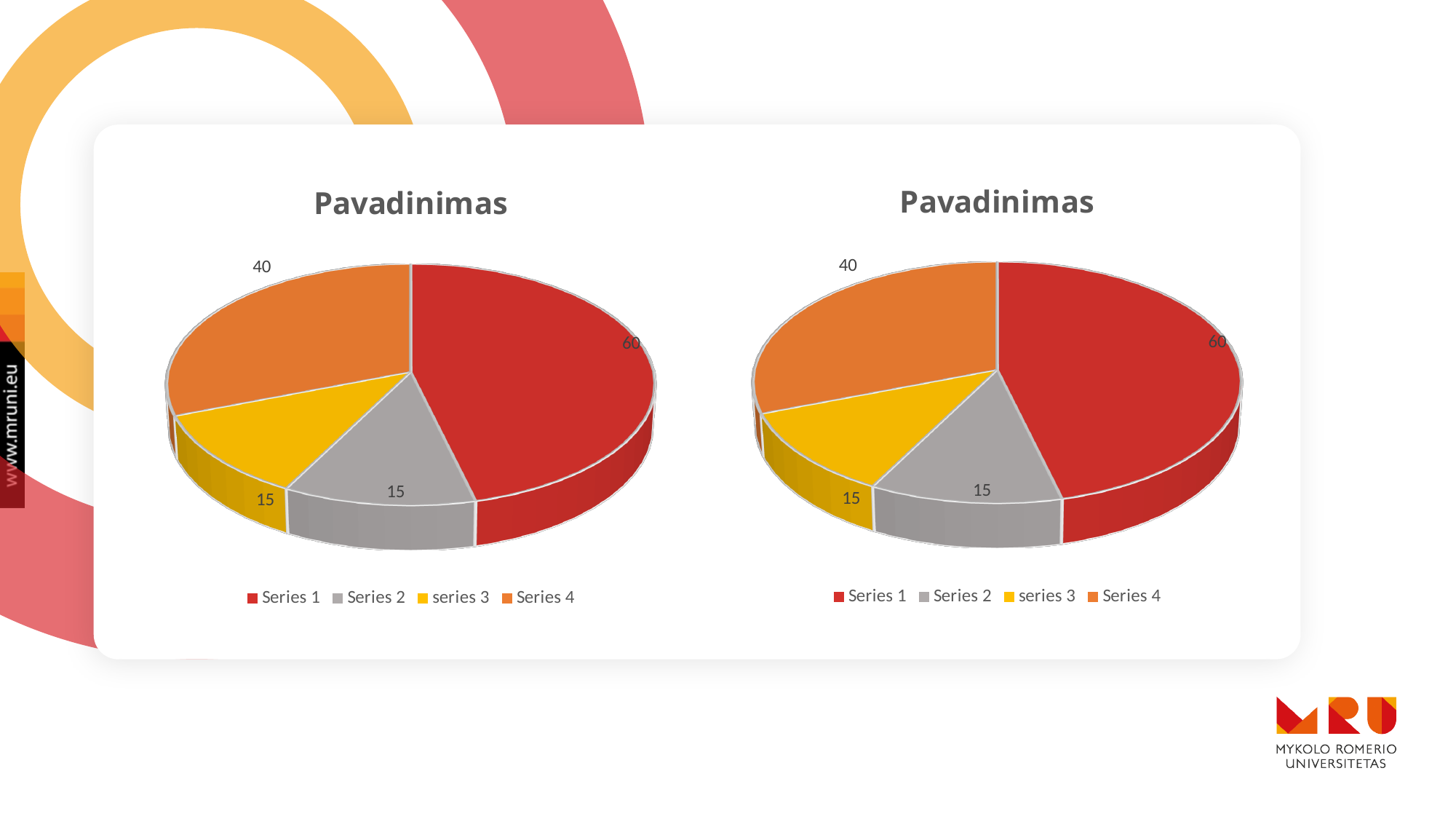
On the right chart, which series has the largest slice? Series 1 On the left chart, what is the value for Series 1? 60 How many series does the legend of the left chart list? 4 On the right chart, what is the value for Series 4? 40 On the left chart, what colour is the Series 2 slice? Grey On the left chart, what is the difference between the values for Series 1 and Series 4? 20 What is the title of the right chart? Pavadinimas On the right chart, what is the difference between the values for Series 4 and series 3? 25 On the left chart, which is larger, the value for Series 4 or the value for Series 2? Series 4 On the left chart, what is the value for Series 2? 15 What kind of chart is the left chart? Pie chart How many slices does the right chart have? 4